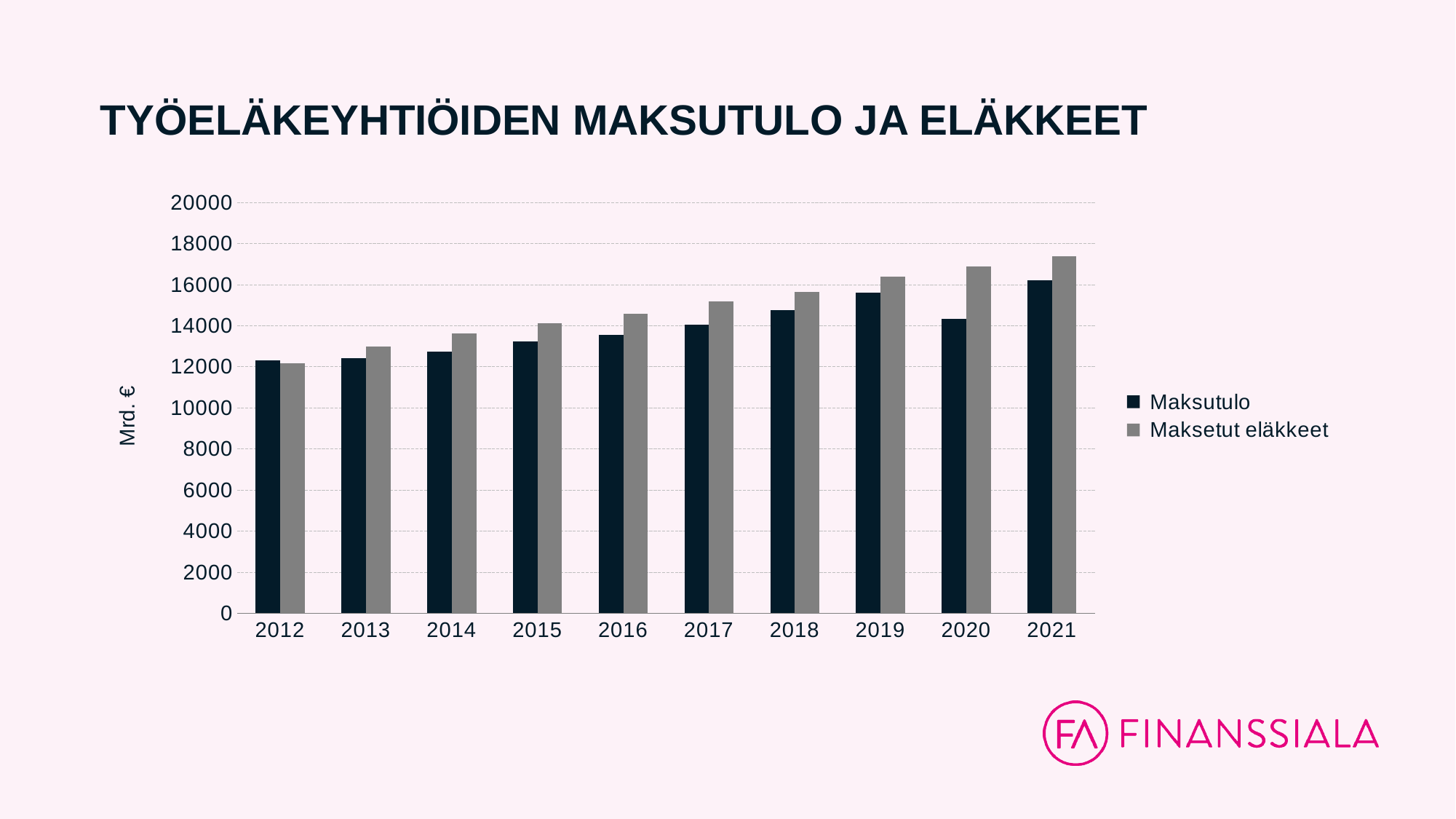
In which year is Maksetut eläkkeet highest? 2021 Is the value for Maksetut eläkkeet in 2014 greater or less than 14000? less In 2020, which is larger: Maksutulo or Maksetut eläkkeet? Maksetut eläkkeet In which year is Maksutulo highest? 2021 How many series does the legend list? 2 In which year is Maksetut eläkkeet lowest? 2012 Is the value for Maksutulo in 2020 greater or less than 16000? less What is the label on the vertical axis? Mrd. € Is the value for Maksetut eläkkeet in 2021 greater or less than 16000? greater What kind of chart is shown on the slide? bar chart Do the values for Maksetut eläkkeet rise or fall from 2012 to 2021? rise How many years are shown on the x axis? 10